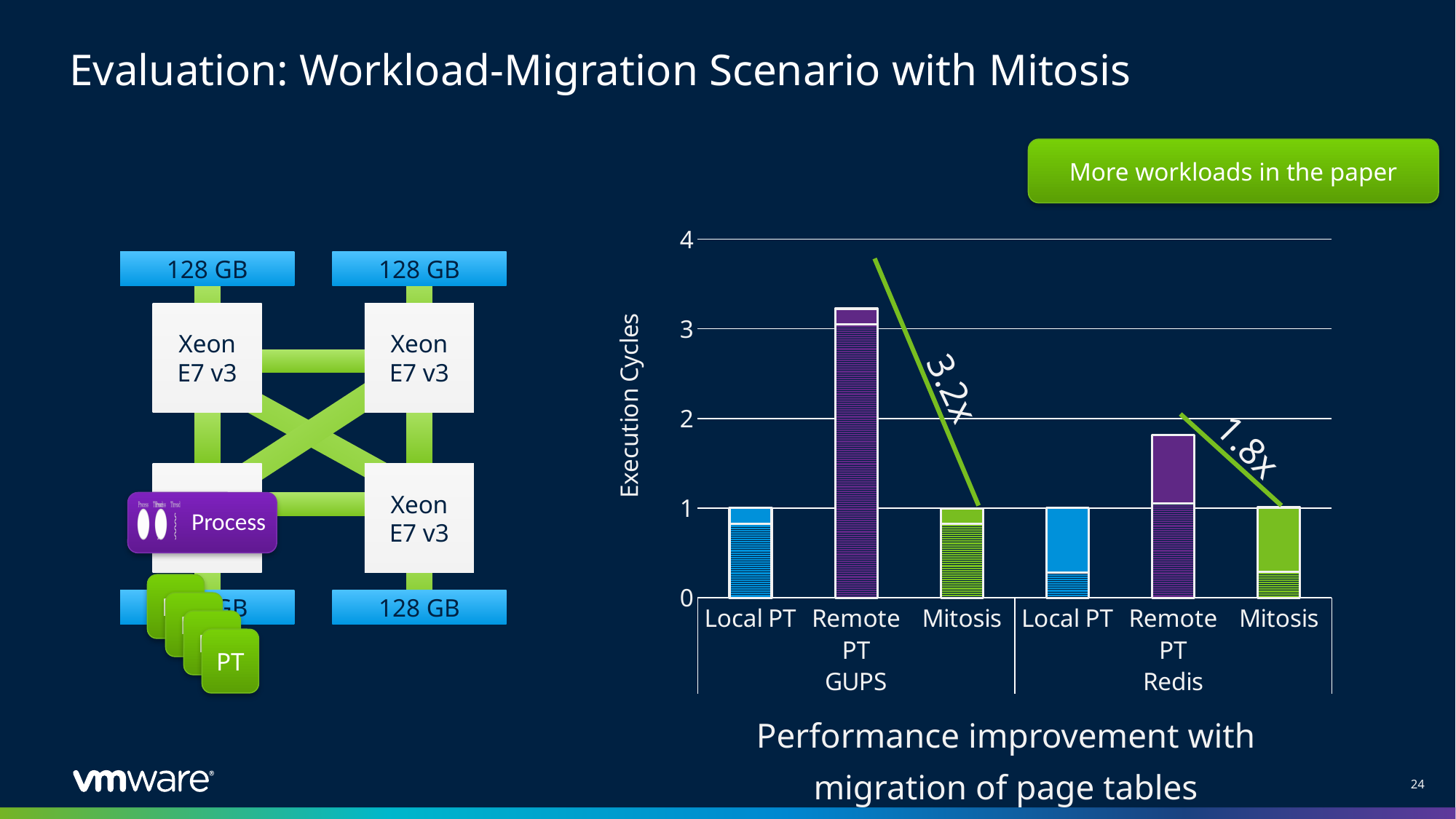
How many bars are plotted in the chart? 6 What is the label of the y axis of the chart? Execution Cycles What speedup is annotated between Remote PT and Mitosis for Redis? 1.8x What is the value of the Local PT bar for GUPS? 1 Is the value for Remote PT under GUPS greater or less than 3? greater Is the value for Remote PT under Redis greater or less than 2? less Which is larger, the Remote PT bar for GUPS or the Remote PT bar for Redis? Remote PT for GUPS What kind of chart is shown on the right of the slide? bar chart What speedup is annotated between Remote PT and Mitosis for GUPS? 3.2x Which two workloads are shown on the x axis of the chart? GUPS and Redis Which bar in the chart is the highest? Remote PT (GUPS) Is the value for Remote PT under Redis greater or less than 1? greater